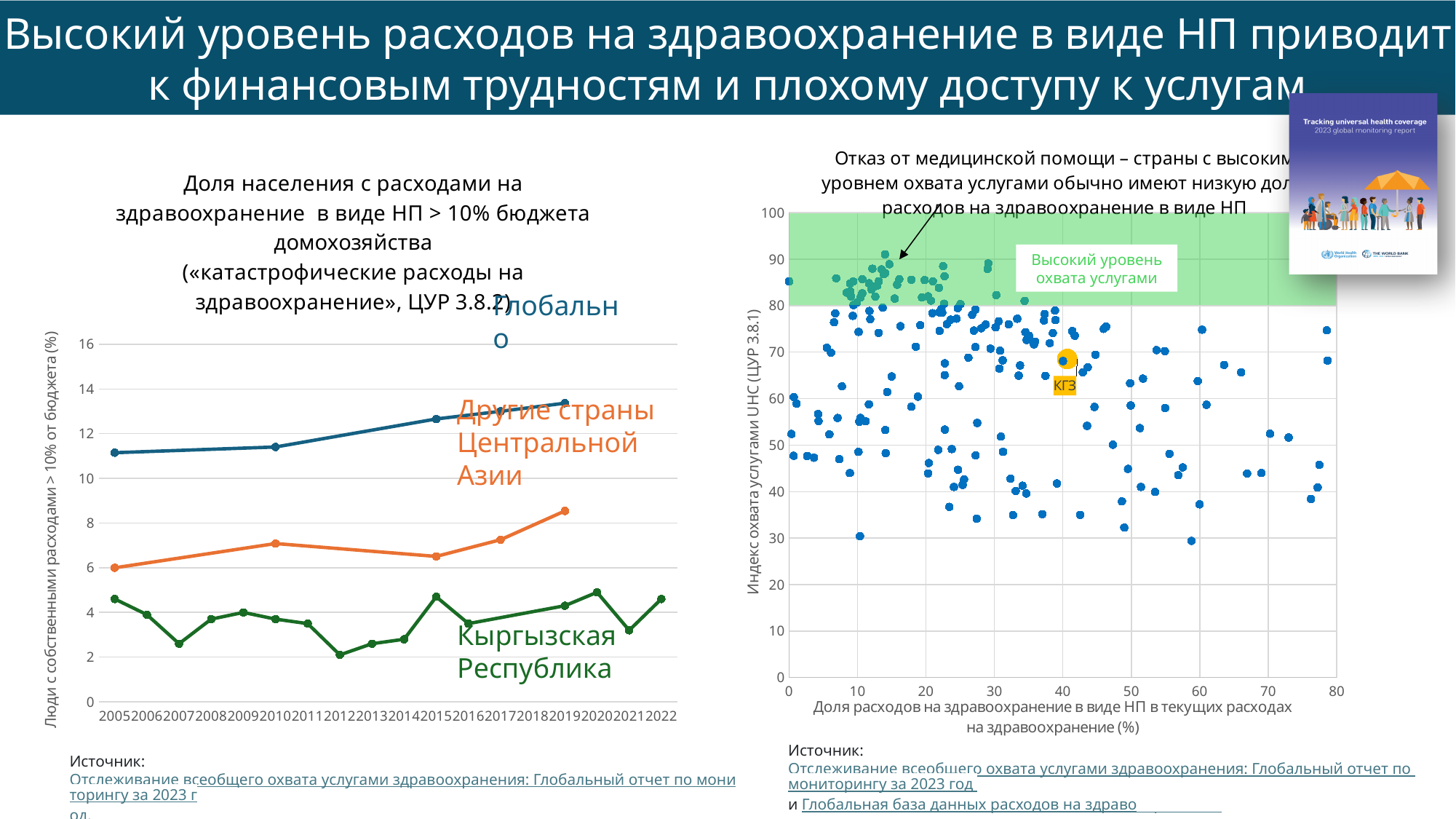
What kind of chart is the right chart plotting the UHC service coverage index against the share of out-of-pocket spending? scatter plot In the left line chart, which series has the lowest values across the whole period? Кыргызская Республика In the left line chart, is the value for Кыргызская Республика in 2012 greater or less than 4? less In the right scatter plot, is the UHC service coverage index for КГЗ greater or less than 80? less In the right scatter plot, what does the green shaded band at the top represent? Высокий уровень охвата услугами In the left line chart, does the Глобально series rise or fall from 2005 to 2019? rises In the left line chart, which is larger in 2019: Другие страны Центральной Азии or Кыргызская Республика? Другие страны Центральной Азии In the left line chart, which series has the highest value in 2019? Глобально What kind of chart is the left chart showing the share of population with catastrophic health spending? line chart In the left line chart, how many series are plotted? 3 In the left line chart, is the value for Глобально in 2019 greater or less than 12? greater